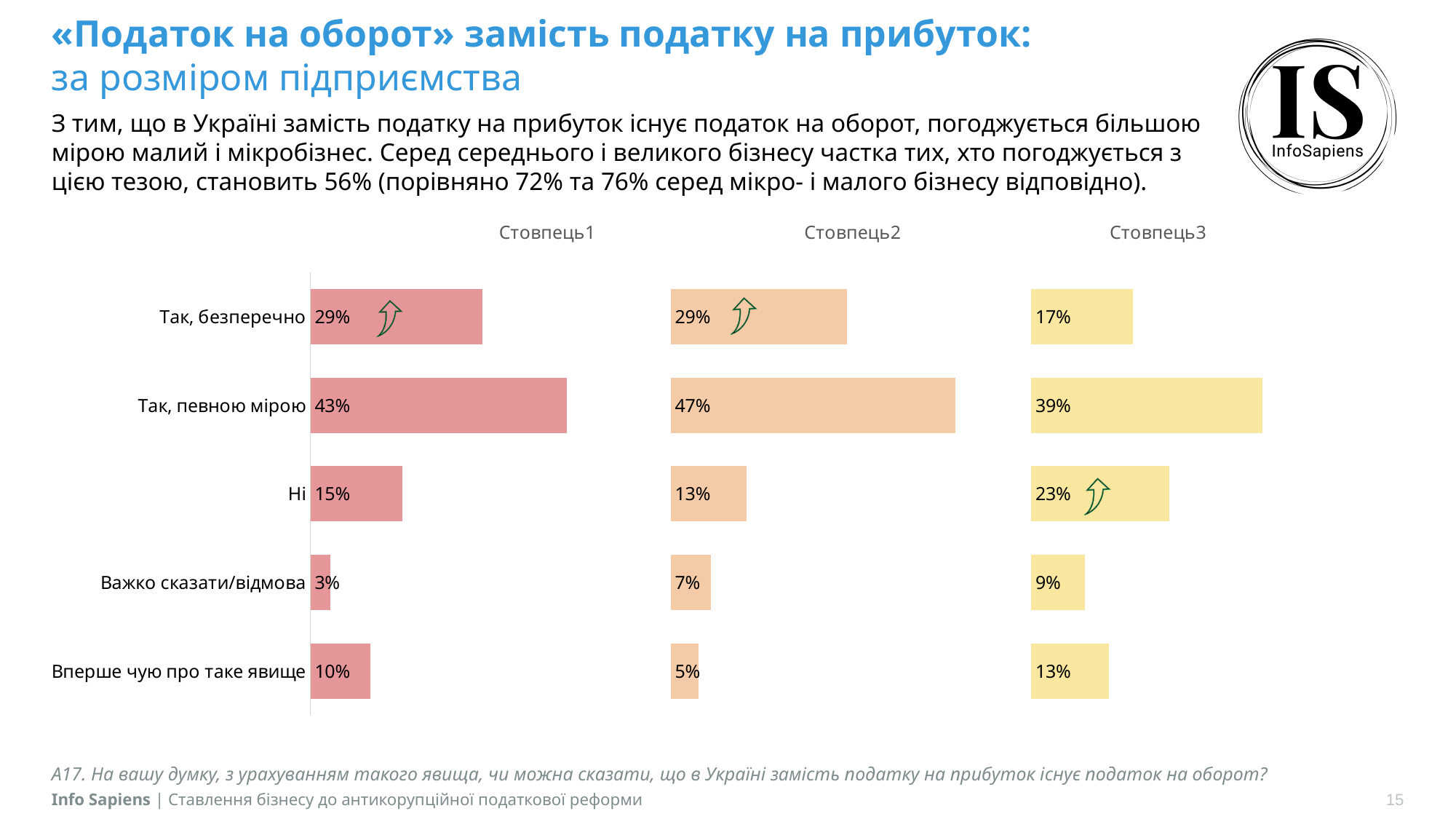
What is the value for «Важко сказати/відмова» in Стовпець2? 7% Which category has the highest value in Стовпець3? Так, певною мірою What is the value for «Вперше чую про таке явище» in Стовпець1? 10% Which is larger: the «Ні» value in Стовпець1 or in Стовпець3? Стовпець3 What is the value for «Так, певною мірою» in Стовпець2? 47% How many response categories are shown in the chart? 5 What is the difference between the «Так, певною мірою» values in Стовпець2 and Стовпець3? 8% How many series (columns) does the chart show? 3 What is the value for «Ні» in Стовпець3? 23% Which category has the lowest value in Стовпець1? Важко сказати/відмова What type of chart is shown on the slide? Bar chart What is the combined value of «Так, безперечно» and «Так, певною мірою» in Стовпець1? 72%